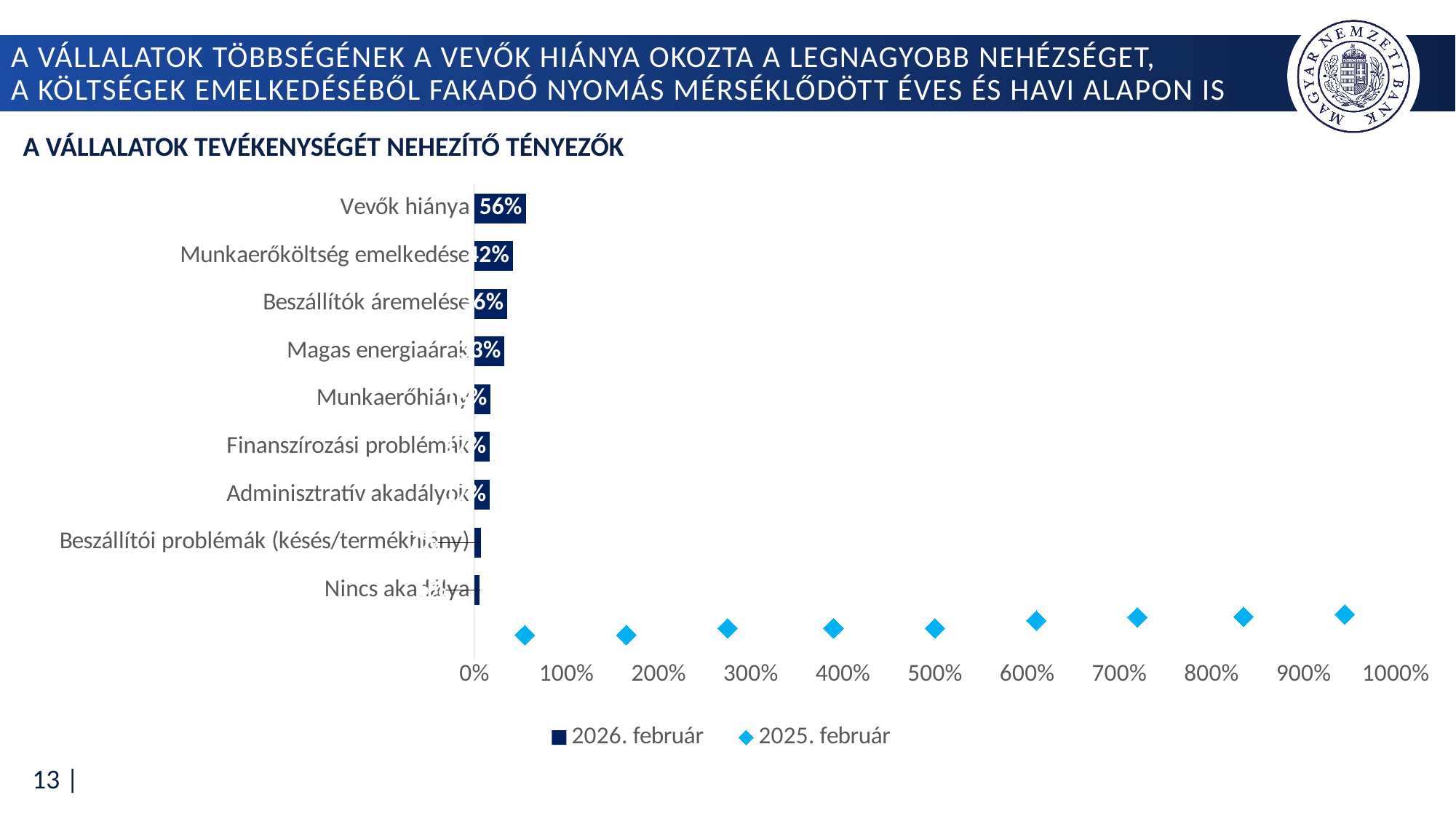
Which has a larger 2026. február bar, Beszállítók áremelése or Nincs akadálya? Beszállítók áremelése How many series does the legend list? 2 Which category has the lowest 2026. február bar? Nincs akadálya What is the value for Munkaerőköltség emelkedése in the 2026. február series? 42% What is the difference between the 2026. február values for Vevők hiánya and Munkaerőköltség emelkedése? 14% Which category has the highest 2026. február bar? Vevők hiánya Which has a larger 2026. február value, Vevők hiánya or Munkaerőköltség emelkedése? Vevők hiánya What kind of chart is shown on the slide? bar chart What is the value for Vevők hiánya in the 2026. február series? 56% Is the 2026. február value for Vevők hiánya greater or less than 100%? less How many categories are shown on the chart? 9 What is the title of the chart? A VÁLLALATOK TEVÉKENYSÉGÉT NEHEZÍTŐ TÉNYEZŐK